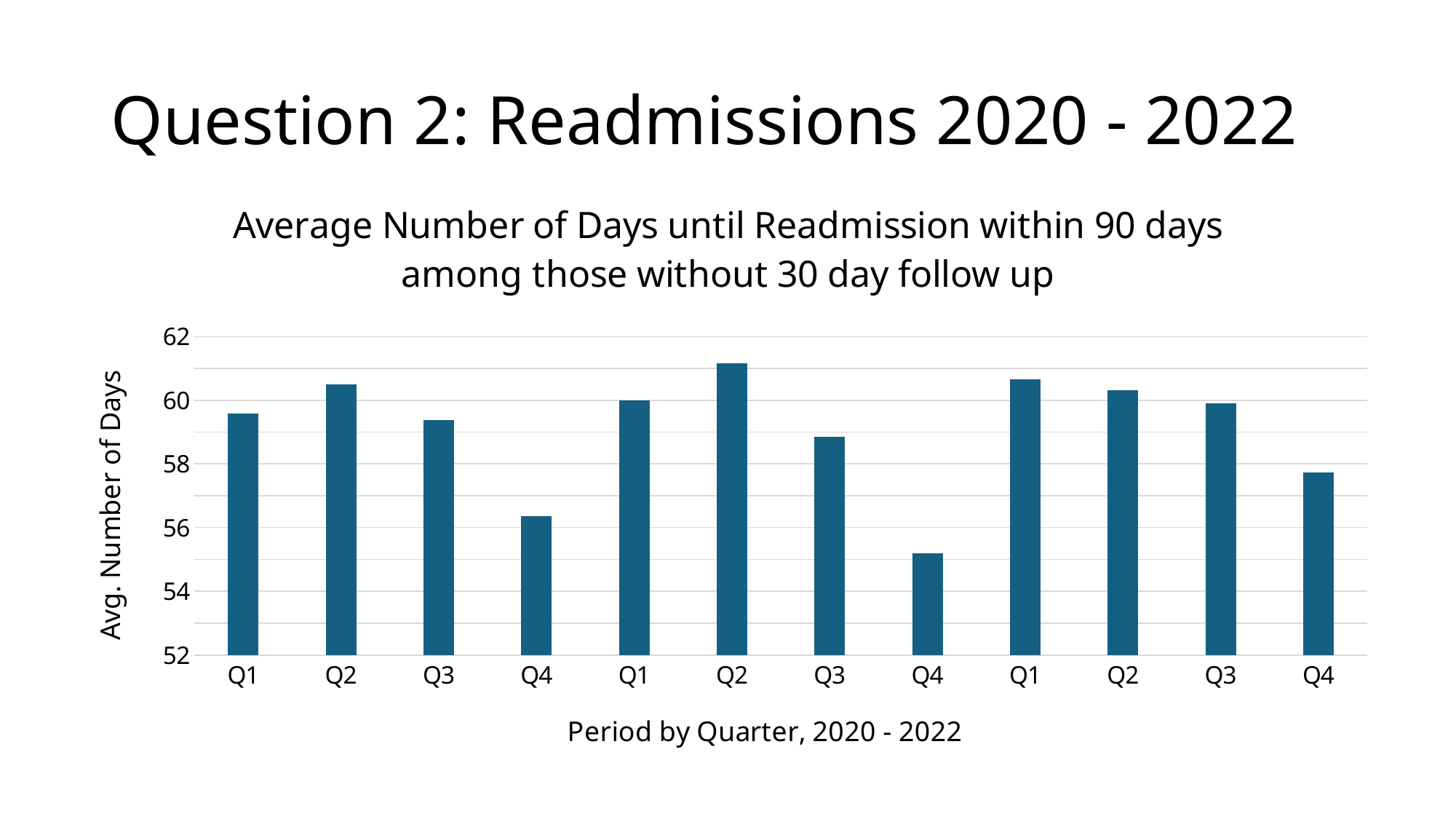
Which is larger, the first Q1 bar (leftmost) or the third Q1 bar (ninth from the left)? the third Q1 bar Which bar is the highest in the chart? the second Q2 bar (sixth bar from the left) Is the value for the last Q4 bar (rightmost) greater or less than 58? less What is the label of the horizontal axis? Period by Quarter, 2020 - 2022 How many bars are plotted in the chart? 12 What kind of chart is shown on the slide? bar chart Is the value for the first Q4 bar (fourth from the left) greater or less than 58? less Is the value for the second Q4 bar (eighth from the left) greater or less than 56? less Which is larger, the first Q4 bar (fourth from the left) or the second Q4 bar (eighth from the left)? the first Q4 bar What is the label of the vertical axis? Avg. Number of Days Which bar is the lowest in the chart? the second Q4 bar (eighth bar from the left)